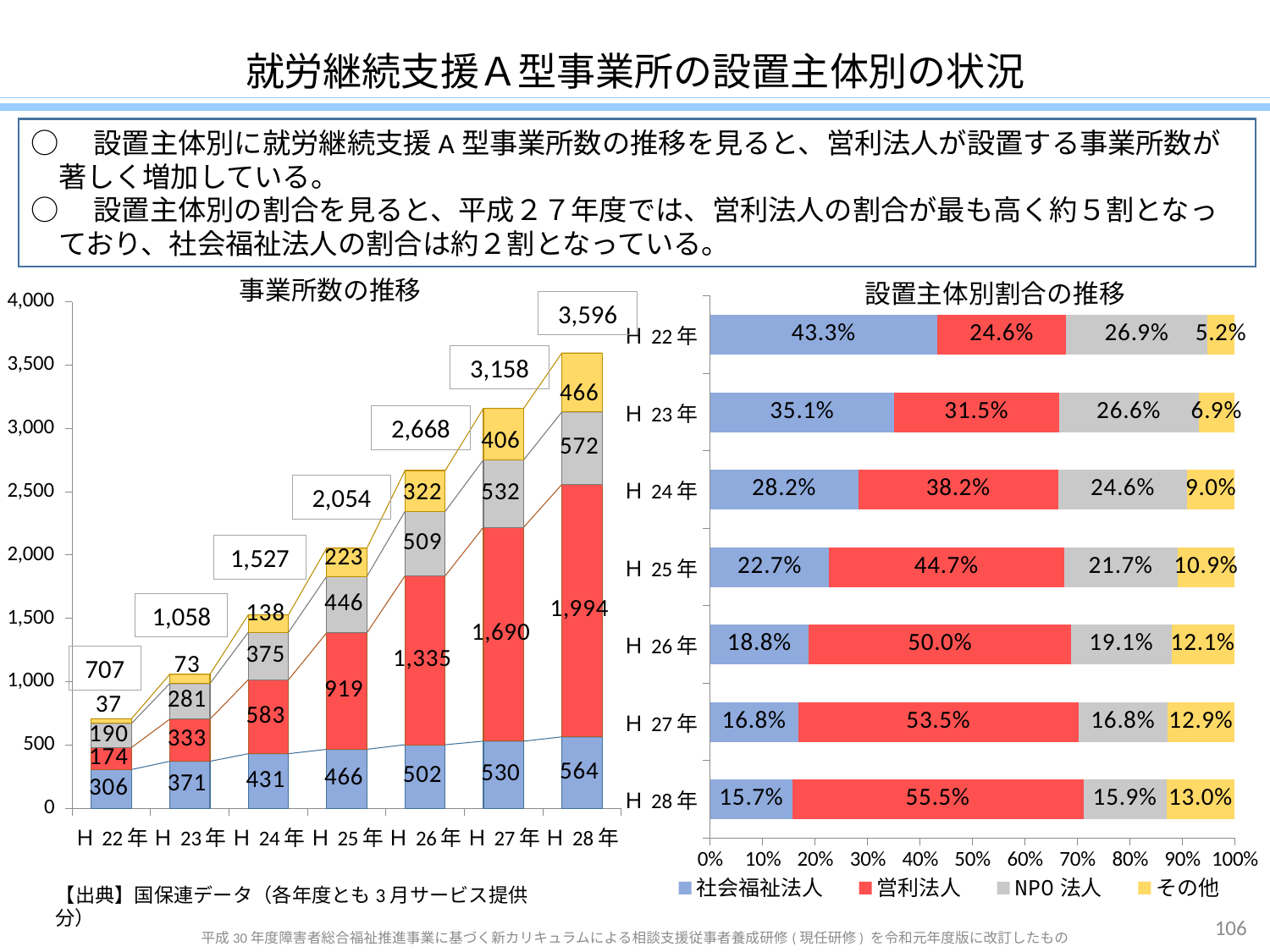
How many series does the legend at the bottom of the slide list? 4 In the chart titled 設置主体別割合の推移, what is the share for 社会福祉法人 in H 22年? 43.3% In the chart titled 事業所数の推移, what is the value for 社会福祉法人 (blue segment) in H 22年? 306 In the chart titled 設置主体別割合の推移, which year has the highest share for 営利法人? H 28年 In the chart titled 事業所数の推移, what is the value for 営利法人 (red segment) in H 26年? 1,335 In the chart titled 事業所数の推移, what is the total number of establishments in H 28年? 3,596 In the chart titled 事業所数の推移, which year has the lowest total? H 22年 In the chart titled 事業所数の推移, do the totals rise or fall from H 22年 to H 28年? rise In the chart titled 設置主体別割合の推移, is the share for 社会福祉法人 in H 24年 larger or smaller than the share for NPO法人 in the same year? larger In the chart titled 事業所数の推移, how many years are shown on the x axis? 7 In the chart titled 設置主体別割合の推移, what is the share for 営利法人 in H 27年? 53.5% In the chart titled 事業所数の推移, what is the difference between the totals for H 28年 and H 27年? 438